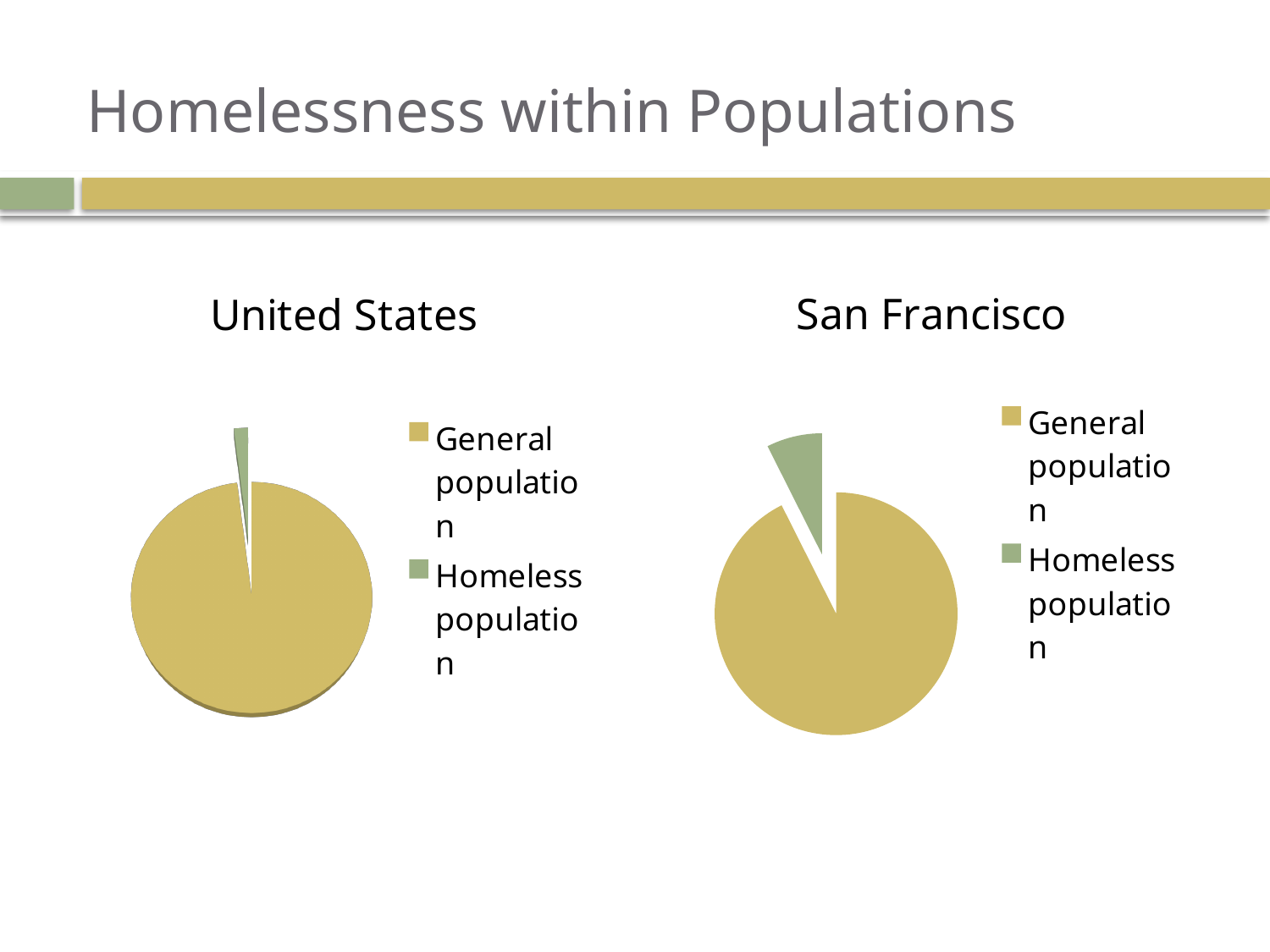
What kind of chart is the United States chart? pie chart In the San Francisco chart, how many slices does the pie have? 2 What is the title of the slide containing the two pie charts? Homelessness within Populations In the United States chart, how many slices does the pie have? 2 In the United States chart, which category has the largest slice? General population How many entries does the legend of the United States chart list? 2 What kind of chart is the San Francisco chart? pie chart In the United States chart, which category has the smallest slice? Homeless population In the San Francisco chart, which category has the smallest slice? Homeless population In the San Francisco chart, what colour is the Homeless population slice? green Which chart shows a larger share for Homeless population, the United States chart or the San Francisco chart? San Francisco In the San Francisco chart, which category has the largest slice? General population